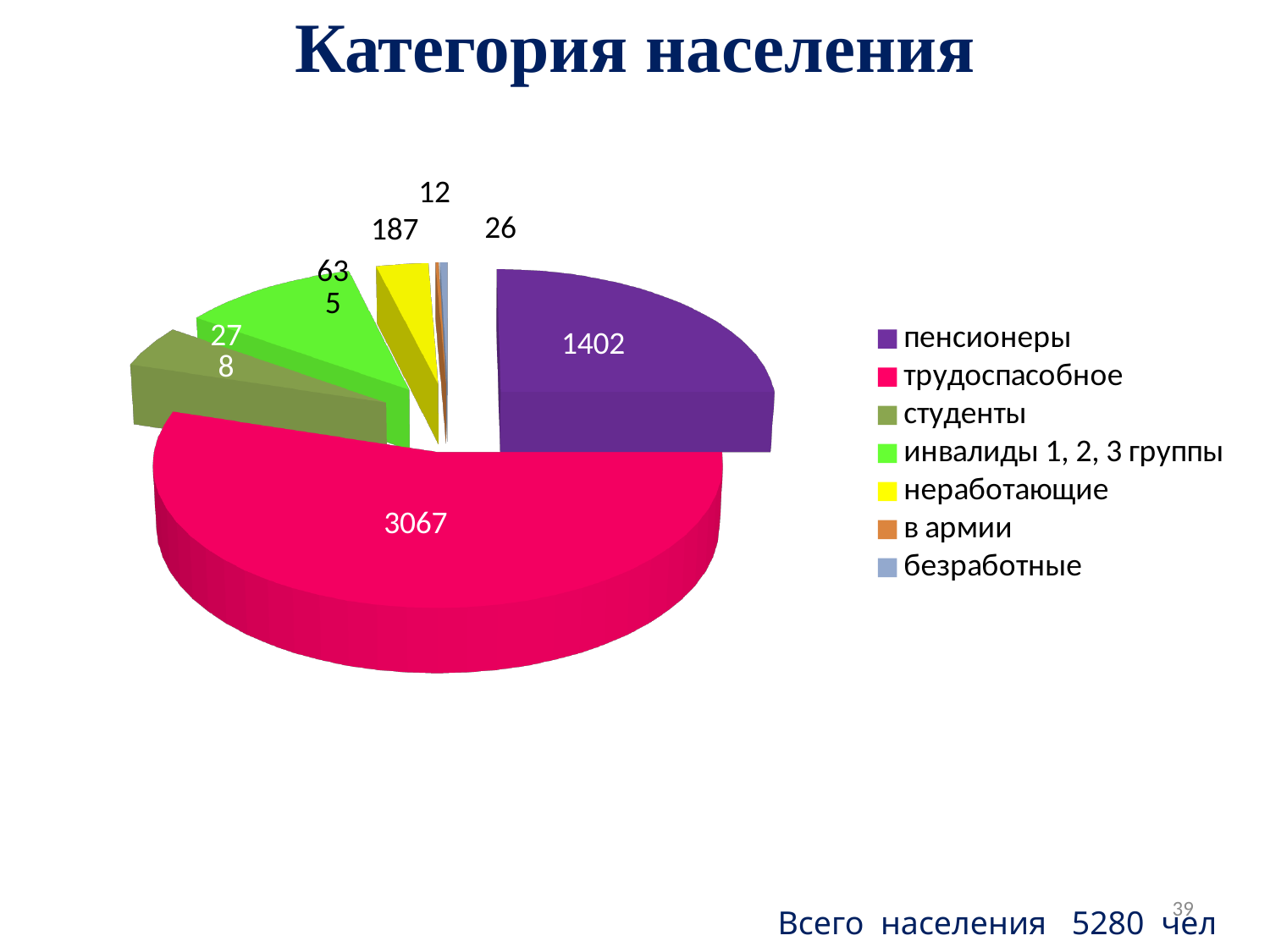
What is the difference between the values for трудоспасобное and пенсионеры? 1665 What is the value for инвалиды 1, 2, 3 группы? 635 Which is larger, the value for студенты or the value for инвалиды 1, 2, 3 группы? инвалиды 1, 2, 3 группы What type of chart is shown on the slide? pie chart What is the value for трудоспасобное? 3067 What is the value for студенты? 278 What is the value for пенсионеры? 1402 What is the value for неработающие? 187 How many categories does the legend list? 7 What is the title of the chart? Категория населения What colour is the slice for пенсионеры? purple Which category has the largest slice? трудоспасобное